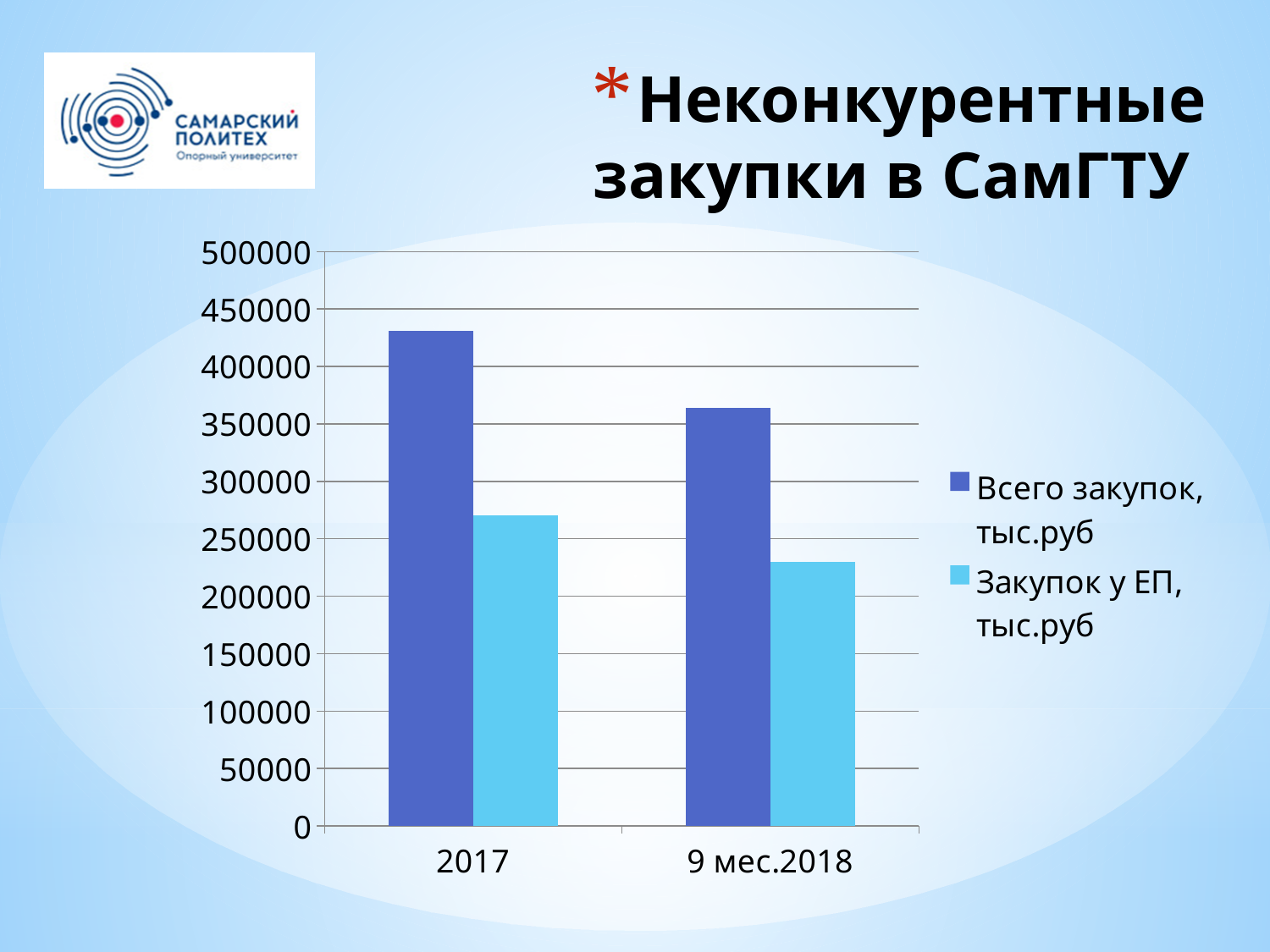
What kind of chart is shown on the slide? bar chart How many series does the legend list? 2 Which category has the lowest value for Закупок у ЕП, тыс.руб? 9 мес.2018 Do the values for Всего закупок, тыс.руб rise or fall from 2017 to 9 мес.2018? fall Which is larger: Всего закупок, тыс.руб in 2017 or in 9 мес.2018? 2017 Is the value for Закупок у ЕП, тыс.руб in 9 мес.2018 greater or less than 250000? less What is the title of the slide containing the chart? Неконкурентные закупки в СамГТУ Which category has the highest value for Всего закупок, тыс.руб? 2017 Is the value for Закупок у ЕП, тыс.руб in 2017 greater or less than 250000? greater Is the value for Всего закупок, тыс.руб in 2017 greater or less than 400000? greater How many categories are shown on the x axis? 2